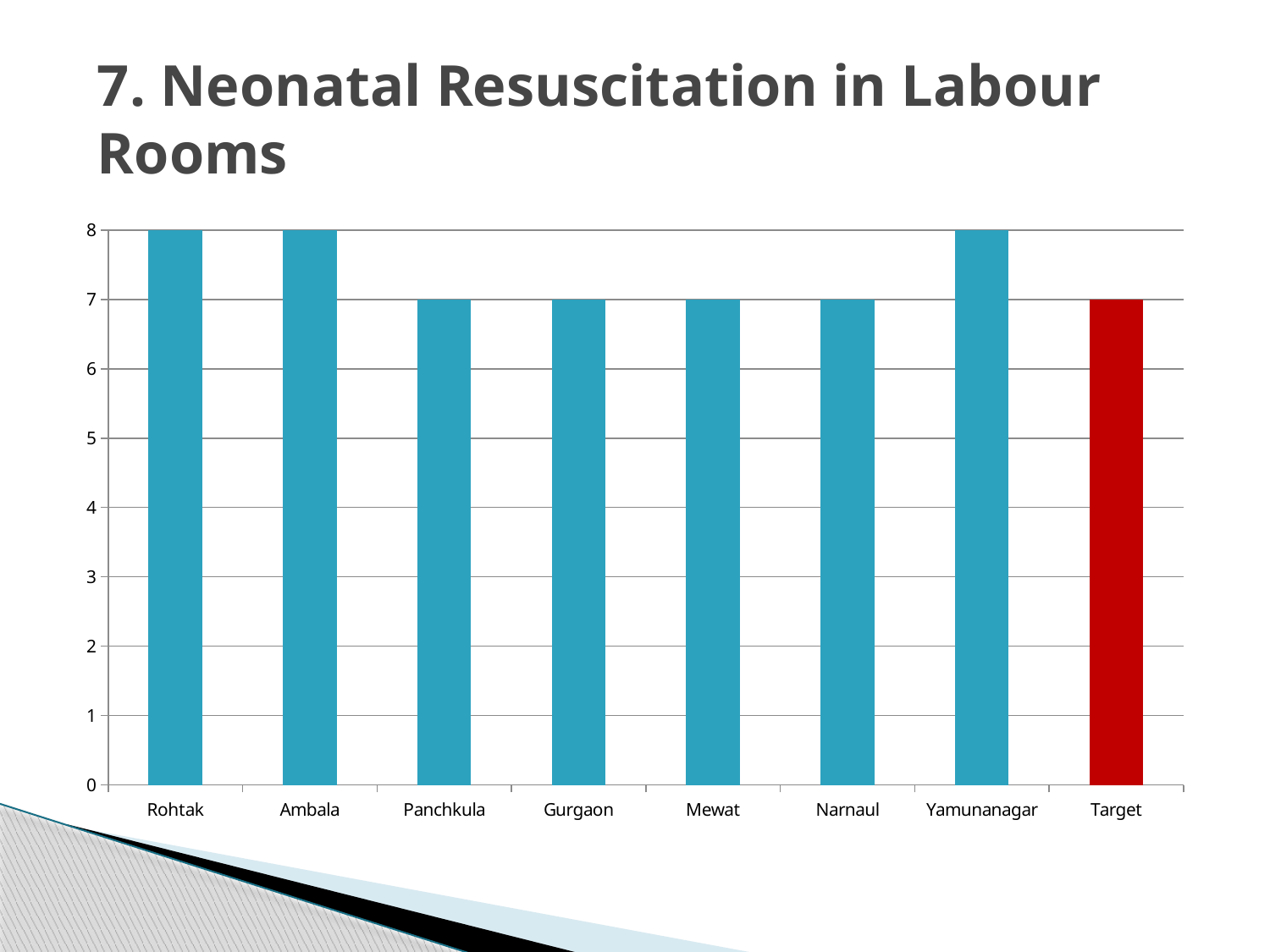
What colour is the Target bar? red What is the value for Panchkula? 7 What is the value for Rohtak? 8 Which is larger, the value for Ambala or the value for Gurgaon? Ambala How many bars reach the value 8? 3 What is the difference between the value for Rohtak and the value for Target? 1 What kind of chart is shown on the slide? bar chart What is the value for Target? 7 What is the value for Narnaul? 7 How many categories are shown on the x axis? 8 Is the value for Mewat greater or less than 5? greater What is the value for Yamunanagar? 8